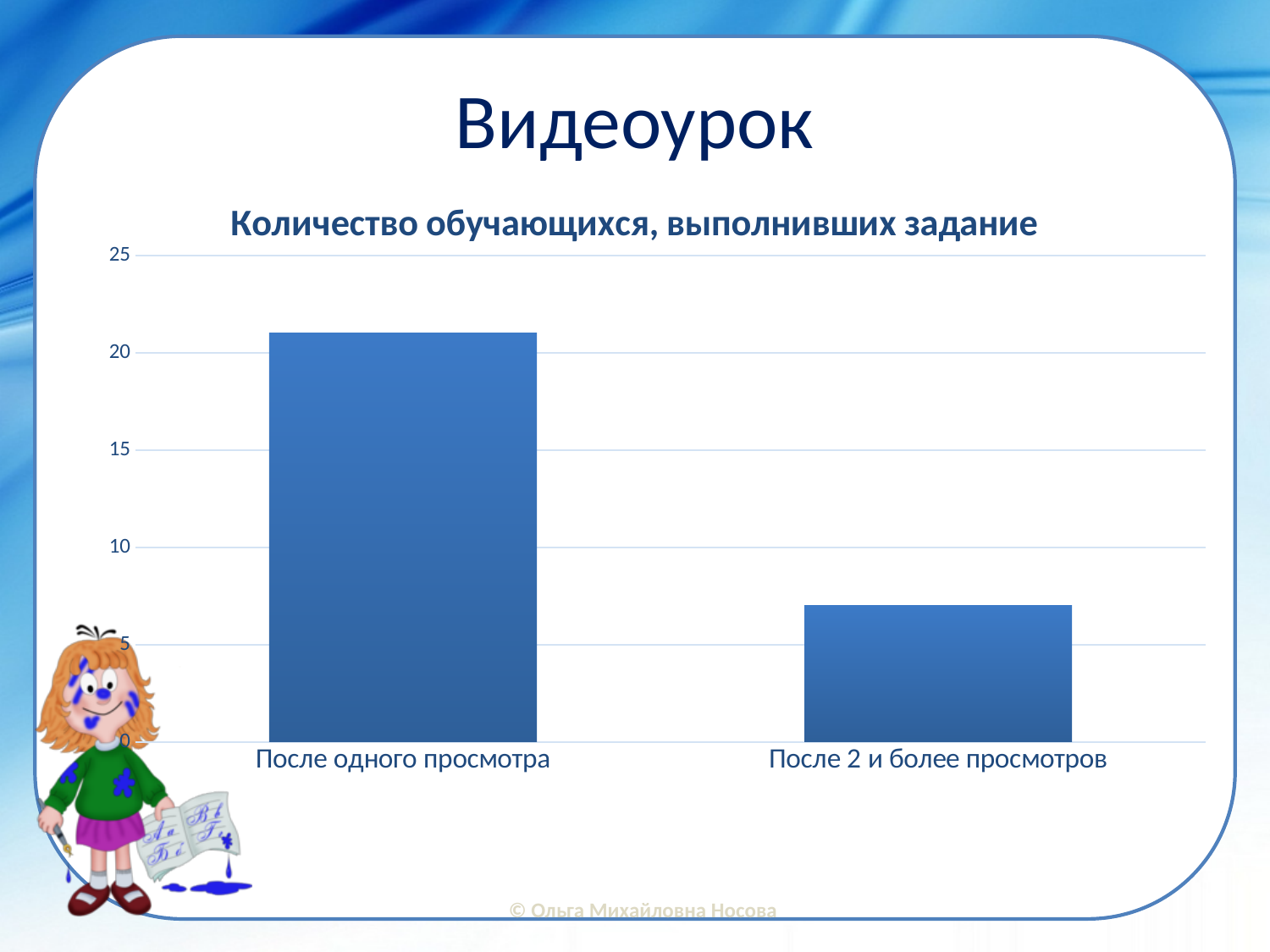
How many categories are shown on the x axis of the chart? 2 Which category has the highest value? После одного просмотра Is the value for 'После 2 и более просмотров' greater or less than 10? less Which is larger: the value for 'После одного просмотра' or the value for 'После 2 и более просмотров'? После одного просмотра Is the value for 'После одного просмотра' greater or less than 25? less Do the values rise or fall from left to right along the x axis? fall Is the value for 'После 2 и более просмотров' greater or less than 5? greater Which category has the lowest value? После 2 и более просмотров What kind of chart is shown on the slide? bar chart What is the highest value shown on the vertical axis of the chart? 25 What is the title of the chart? Количество обучающихся, выполнивших задание